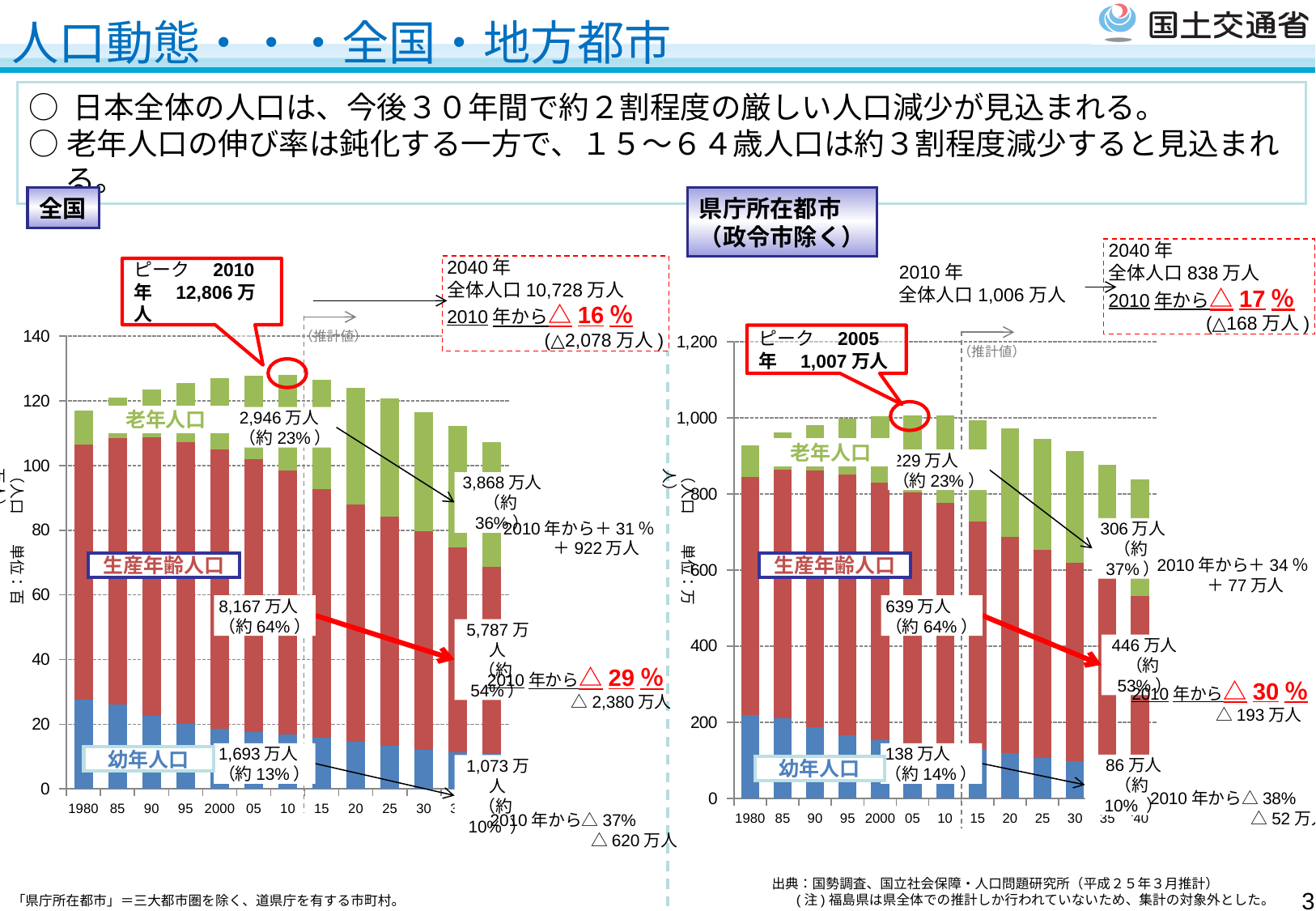
In the 全国 chart, what is the difference between the 2010 total population (12,806万人) and the 2040 total population (10,728万人)? 2,078万人 In the 県庁所在都市 chart, do the total bar heights rise or fall from 2010 to 2040? fall How many year categories are shown on the x axis of the 全国 chart? 13 In the 全国 chart, is the total population for 1980 greater or less than 100? greater How many population groups (series) are stacked in each bar of the 県庁所在都市 chart? 3 What kind of chart is the 全国 chart on the left? stacked bar chart In the 全国 chart, which year is marked as the peak of total population? 2010年 In the 県庁所在都市 chart, what is the 老年人口 value labelled for 2040? 306万人 In the 県庁所在都市 chart, is the 2040 幼年人口 (86万人) larger or smaller than the 2010 幼年人口 (138万人)? smaller In the 全国 chart, what is the peak total population value labelled for 2010? 12,806万人 In the 全国 chart, what is the 生産年齢人口 value labelled for 2040? 5,787万人 In the 県庁所在都市 chart, which year is marked as the peak of total population? 2005年